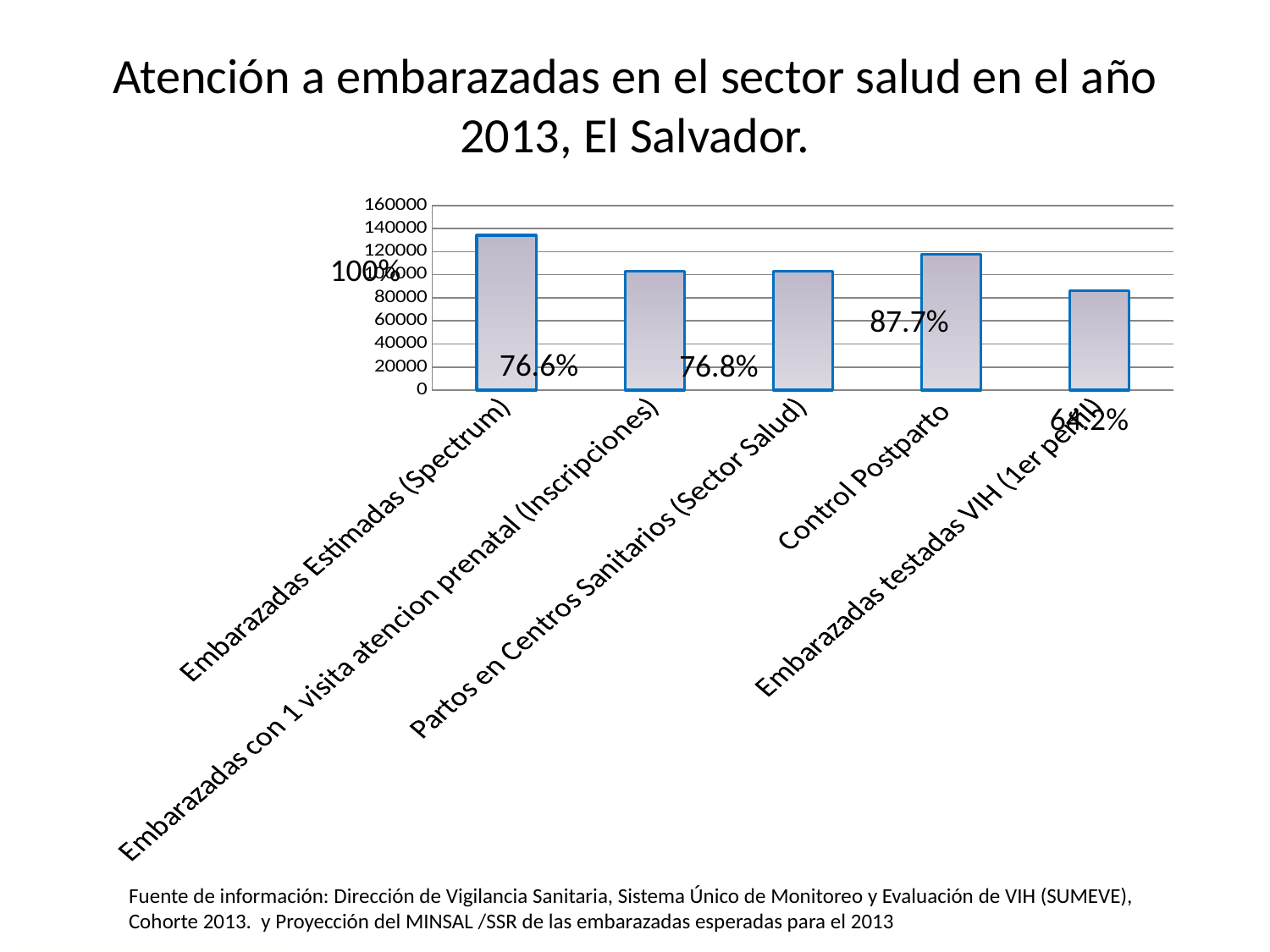
Which category has the lowest bar? Embarazadas testadas VIH (1er perfil) What kind of chart is shown on the slide? bar chart Is the value for Control Postparto greater or less than 100000? greater How many categories are plotted on the chart? 5 What percentage label is shown for Control Postparto? 87.7% Which is larger, the value for Control Postparto or the value for Partos en Centros Sanitarios (Sector Salud)? Control Postparto What is the highest value shown on the vertical axis? 160000 Is the value for Partos en Centros Sanitarios (Sector Salud) greater or less than 120000? less Which category has the highest bar? Embarazadas Estimadas (Spectrum) Is the value for Embarazadas testadas VIH (1er perfil) greater or less than 100000? less What is the title of the slide containing the chart? Atención a embarazadas en el sector salud en el año 2013, El Salvador.